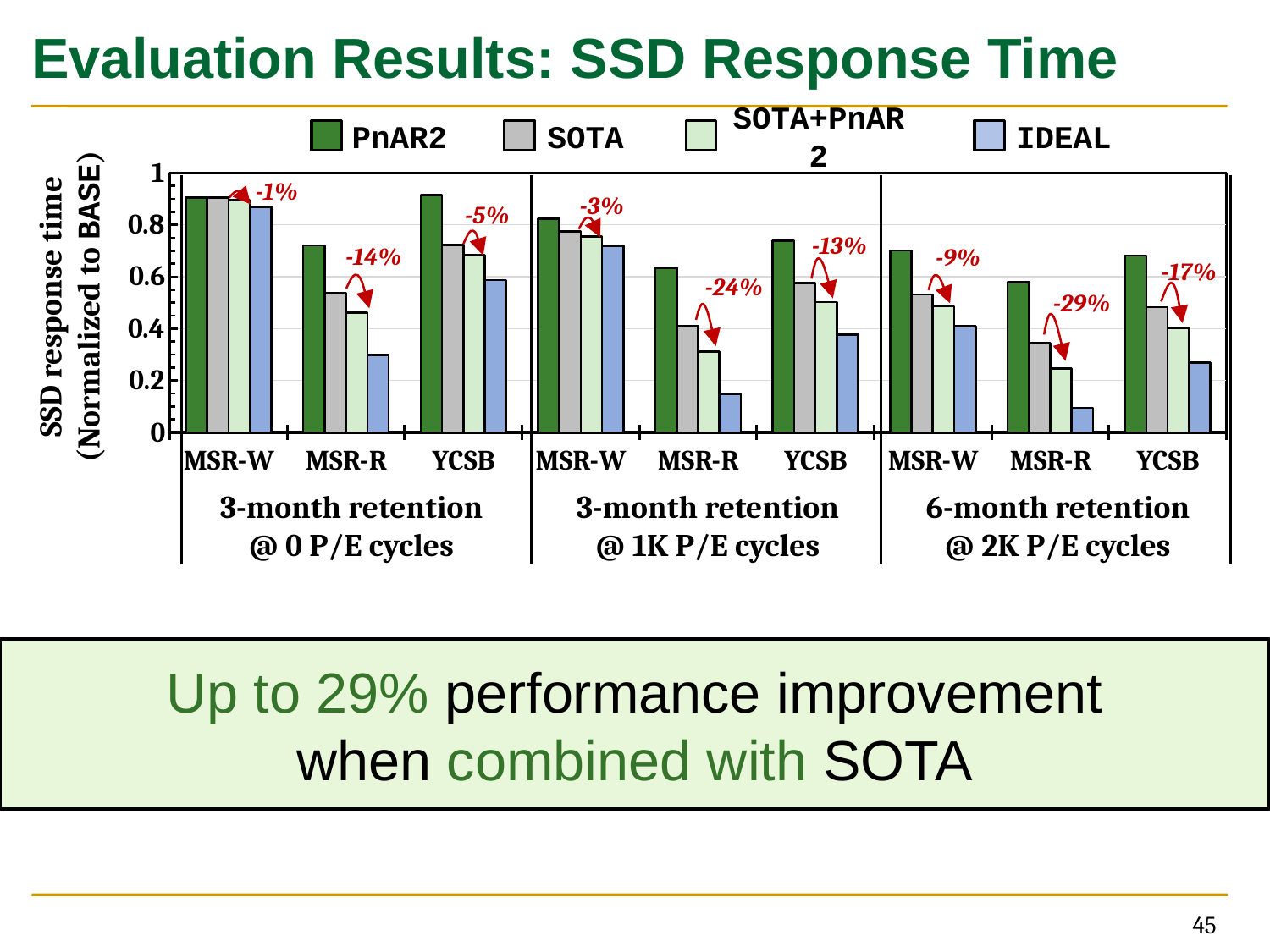
For MSR-R under 3-month retention @ 0 P/E cycles, which is larger: the PnAR2 bar or the IDEAL bar? PnAR2 Which series is drawn in dark green in the legend? PnAR2 How many retention/P-E cycle conditions are shown along the x axis? 3 How many series does the legend list? 4 Which workload and condition has the largest annotated reduction in SSD response time? MSR-R under 6-month retention @ 2K P/E cycles (-29%) What percentage reduction is annotated for MSR-W under 3-month retention @ 0 P/E cycles? -1% Is the PnAR2 value for MSR-W under 3-month retention @ 0 P/E cycles greater or less than 0.8? greater What kind of chart is shown on the slide? bar chart Is the IDEAL value for MSR-R under 3-month retention @ 1K P/E cycles greater or less than 0.2? less What percentage reduction is annotated for MSR-R under 3-month retention @ 1K P/E cycles? -24% What percentage reduction is annotated for YCSB under 6-month retention @ 2K P/E cycles? -17% How many workload categories (MSR-W, MSR-R, YCSB groups) are plotted in total across the chart? 9